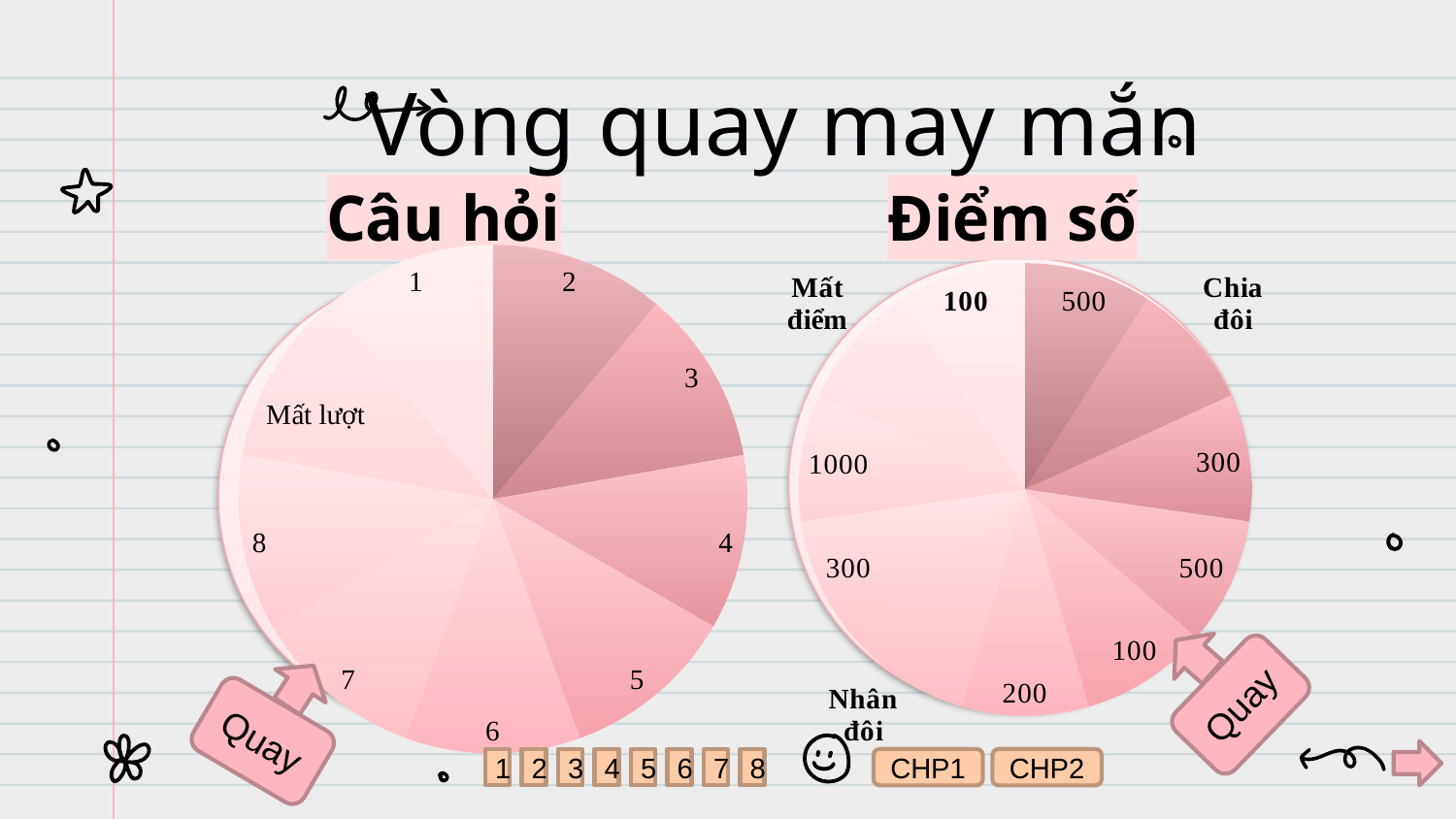
On the "Câu hỏi" chart, which slice label is not a number? Mất lượt What is the title of the chart on the left? Câu hỏi How many slices does the "Câu hỏi" pie chart on the left have? 9 What kind of chart is the "Điểm số" chart on the right? pie chart What is the title of the chart on the right? Điểm số On the "Điểm số" chart, what is the largest numeric slice label? 1000 On the "Điểm số" chart, what is the smallest numeric slice label? 100 On the "Điểm số" chart, which slice label sits between "500" and "300" at the top right? Chia đôi What kind of chart is the "Câu hỏi" chart on the left? pie chart On the "Điểm số" chart, which slice label sits between "1000" and "100" at the top left? Mất điểm